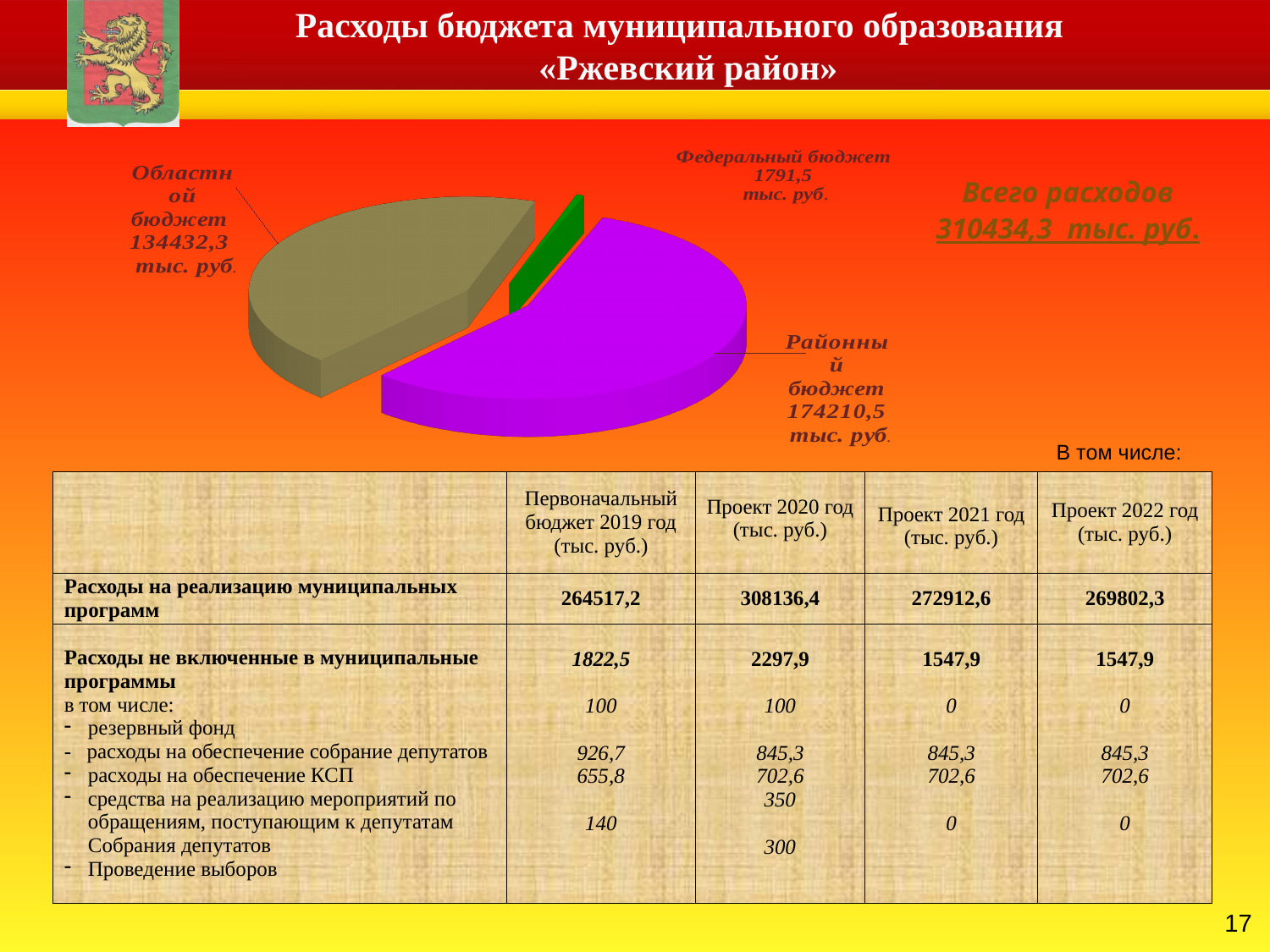
What colour is the Федеральный бюджет slice in the pie chart? Green Which is larger in the pie chart: Областной бюджет or Федеральный бюджет? Областной бюджет Which budget source has the largest slice in the pie chart? Районный бюджет What colour is the Районный бюджет slice in the pie chart? Magenta (purple) What is the total of all expenditures shown next to the pie chart (Всего расходов)? 310434,3 тыс. руб. Which budget source has the smallest slice in the pie chart? Федеральный бюджет What is the value of the Областной бюджет slice in the pie chart? 134432,3 тыс. руб. What is the value of the Федеральный бюджет slice in the pie chart? 1791,5 тыс. руб. What type of chart is shown on the slide? Pie chart By how much does the Районный бюджет exceed the Областной бюджет in the pie chart? 39778,2 тыс. руб. What is the value of the Районный бюджет slice in the pie chart? 174210,5 тыс. руб. How many slices does the pie chart have? 3